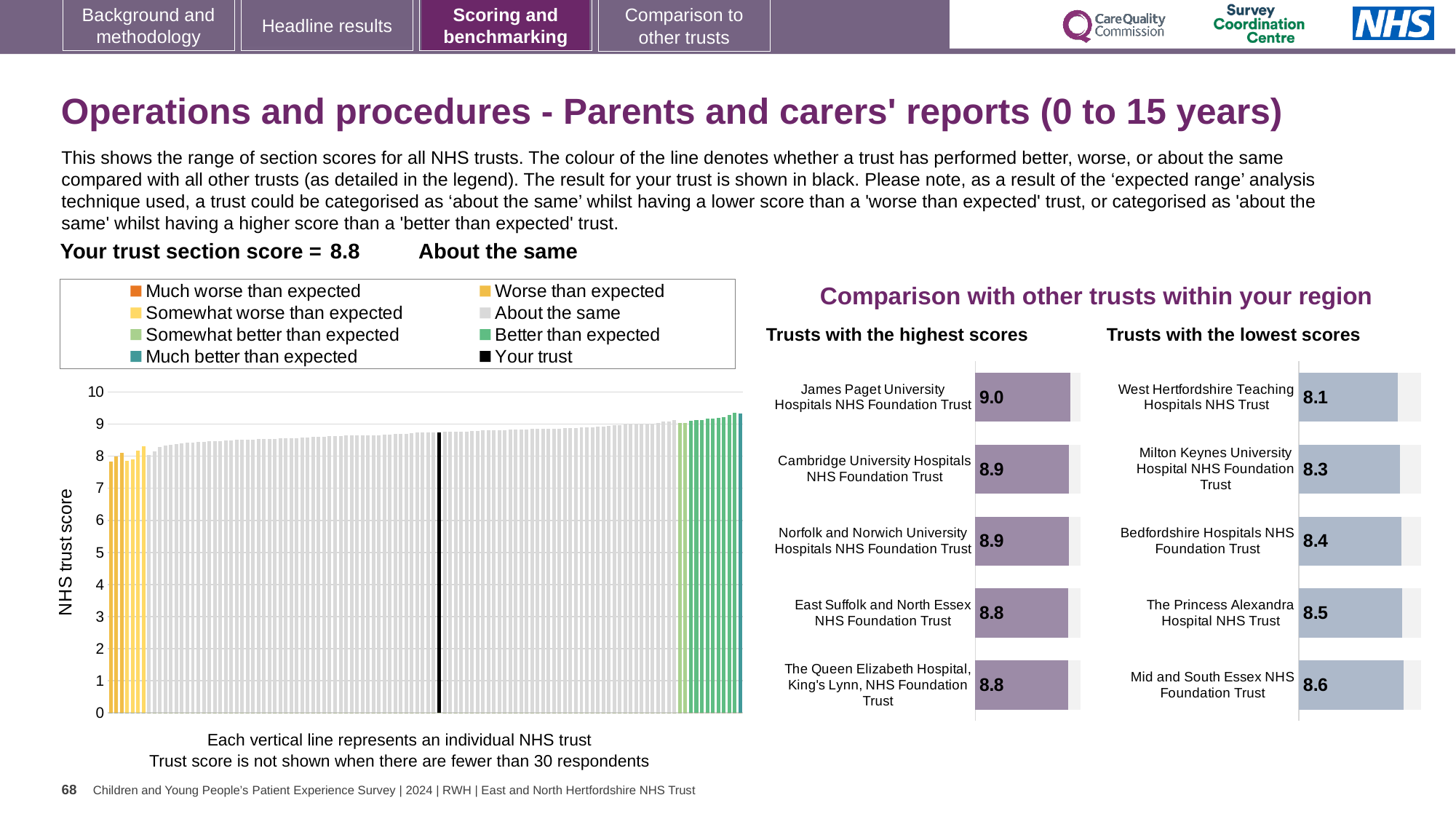
In the large chart on the left, is the value for the black 'Your trust' bar greater or less than 8? greater In the 'Trusts with the highest scores' chart, what is the score for James Paget University Hospitals NHS Foundation Trust? 9.0 In the 'Trusts with the highest scores' chart, what is the difference between the scores of James Paget University Hospitals NHS Foundation Trust and East Suffolk and North Essex NHS Foundation Trust? 0.2 In the 'Trusts with the highest scores' chart, which trust has the highest score? James Paget University Hospitals NHS Foundation Trust In the 'Trusts with the lowest scores' chart, what is the score for Milton Keynes University Hospital NHS Foundation Trust? 8.3 In the 'Trusts with the lowest scores' chart, what is the difference between the scores of Mid and South Essex NHS Foundation Trust and West Hertfordshire Teaching Hospitals NHS Trust? 0.5 In the large chart on the left, do the trust scores rise or fall from left to right along the x axis? Rise In the 'Trusts with the lowest scores' chart, which trust has the lowest score? West Hertfordshire Teaching Hospitals NHS Trust What kind of chart is the large chart on the left showing all NHS trusts? Bar chart How many entries does the legend above the large chart on the left list? 8 How many trusts are listed in the 'Trusts with the highest scores' chart? 5 In the 'Trusts with the lowest scores' chart, which has the higher score: Bedfordshire Hospitals NHS Foundation Trust or Milton Keynes University Hospital NHS Foundation Trust? Bedfordshire Hospitals NHS Foundation Trust